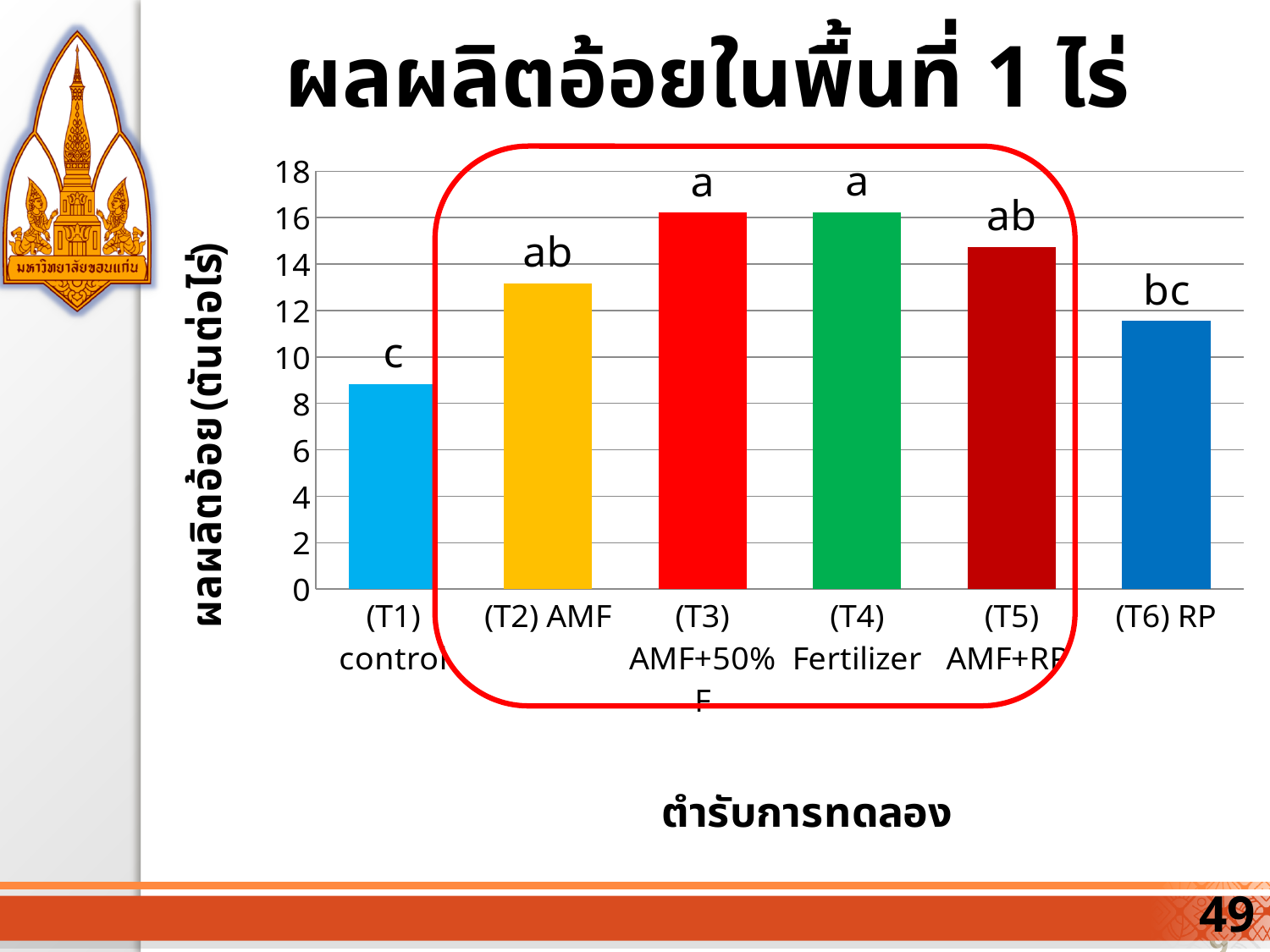
What kind of chart is shown on the slide? bar chart Is the value for (T3) AMF+50% F greater or less than 14? greater Which is larger, the value for (T5) AMF+RP or the value for (T2) AMF? (T5) AMF+RP How many treatment categories are plotted on the x axis? 6 Which is larger, the value for (T2) AMF or the value for (T6) RP? (T2) AMF What letter label is printed above the (T1) control bar? c Is the value for (T5) AMF+RP greater or less than 14? greater Which treatment has the lowest sugarcane yield? (T1) control What is the label on the x axis of the chart? ตำรับการทดลอง Is the value for (T1) control greater or less than 10? less